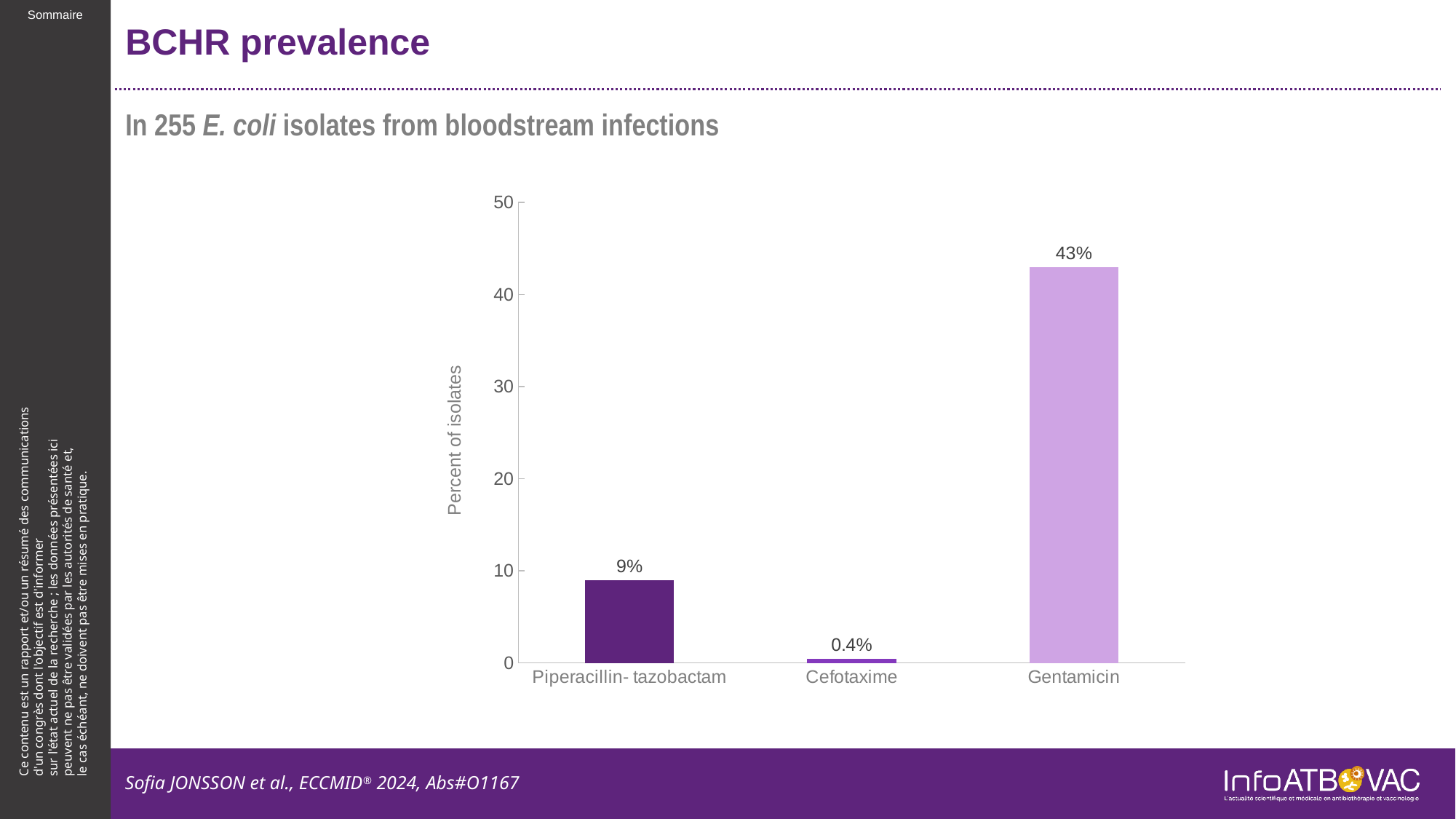
What is the difference between the values for Gentamicin and Piperacillin-tazobactam? 34% What is the difference between the values for Piperacillin-tazobactam and Cefotaxime? 8.6% What is the label of the y axis? Percent of isolates What is the value for Cefotaxime? 0.4% What is the value for Gentamicin? 43% Which is larger, the value for Piperacillin-tazobactam or the value for Cefotaxime? Piperacillin-tazobactam Is the value for Gentamicin greater or less than 40? greater Which antibiotic has the lowest percent of isolates? Cefotaxime What is the value for Piperacillin-tazobactam? 9% How many antibiotics are shown on the x axis? 3 What kind of chart is shown on the slide? Bar chart Which antibiotic has the highest percent of isolates? Gentamicin